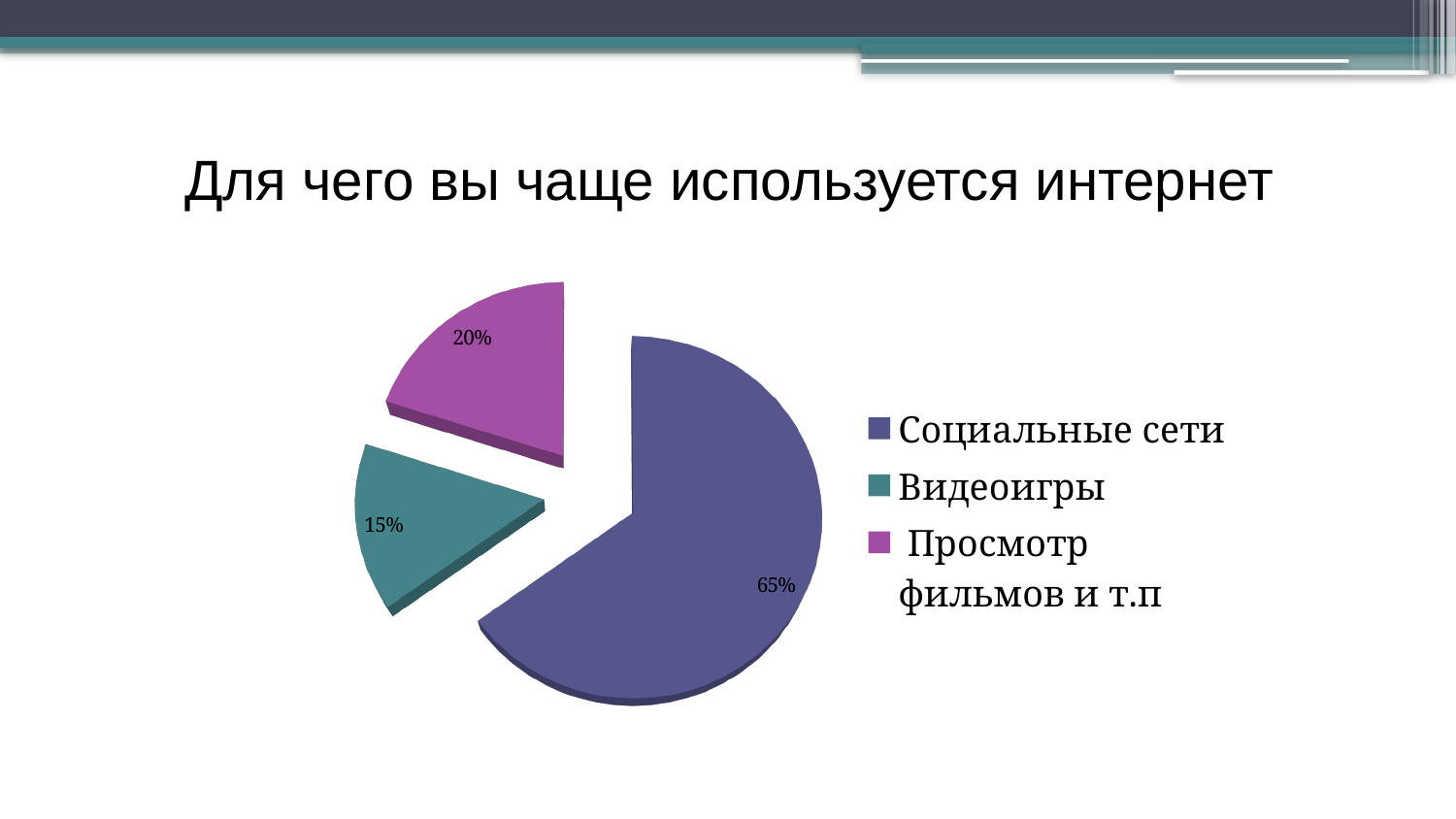
What type of chart is shown on the slide? pie chart What is the difference in percentage points between Социальные сети and Просмотр фильмов и т.п? 45 What colour is the slice for Видеоигры? teal What percentage is shown for Видеоигры? 15% What percentage is shown for Просмотр фильмов и т.п? 20% What percentage is shown for Социальные сети? 65% Which category has the largest share of the pie? Социальные сети What is the difference in percentage points between Просмотр фильмов и т.п and Видеоигры? 5 Which is larger, the share for Видеоигры or the share for Просмотр фильмов и т.п? Просмотр фильмов и т.п How many slices does the pie chart have? 3 How many entries does the legend list? 3 Which category has the smallest share of the pie? Видеоигры